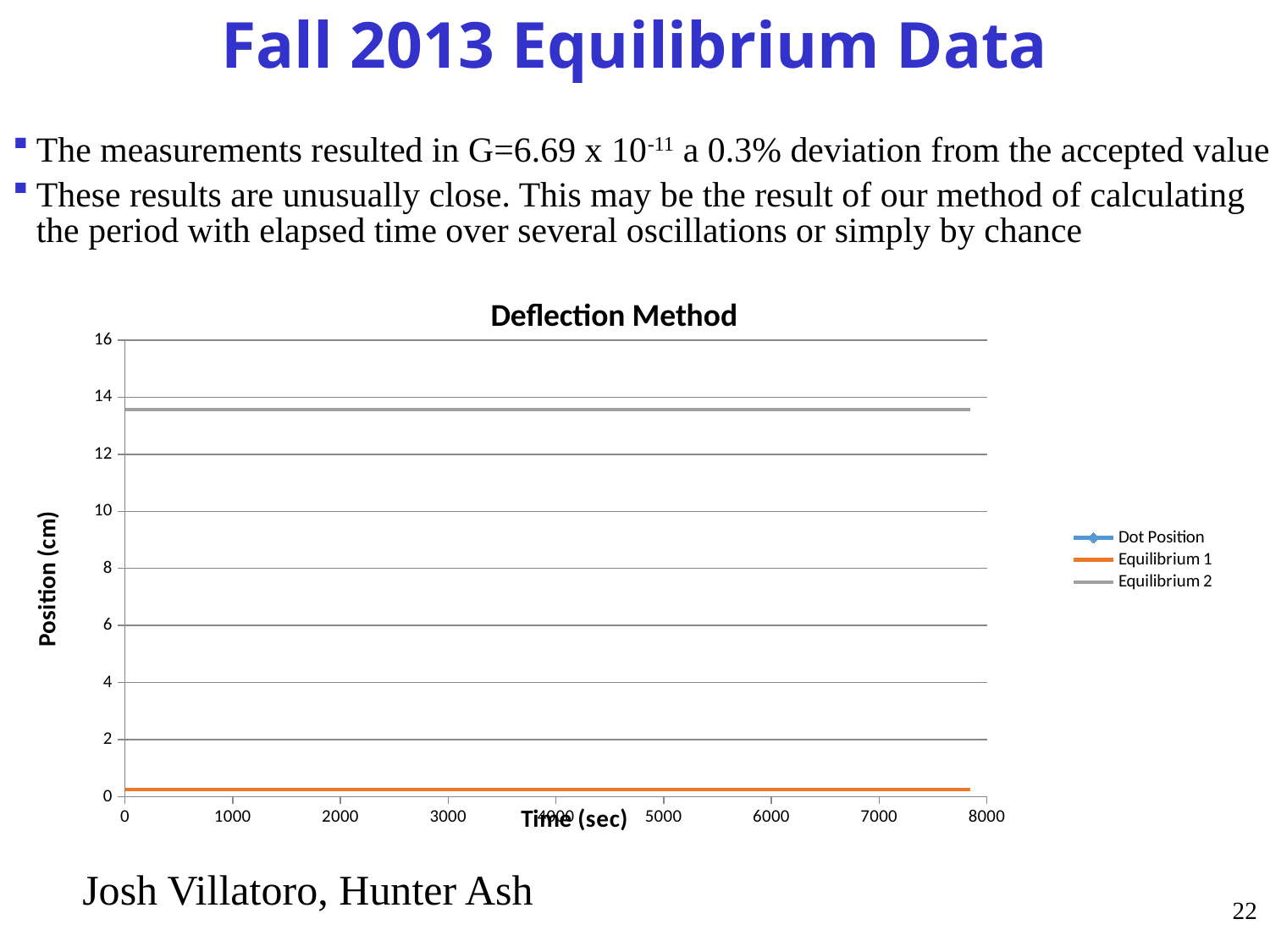
What is the title of the chart on the slide? Deflection Method What is the label of the vertical axis of the chart? Position (cm) What is the highest value shown on the vertical axis of the chart? 16 Which series has the higher position, Equilibrium 1 or Equilibrium 2? Equilibrium 2 Is the value of the Equilibrium 2 line greater or less than 12? greater Does the Equilibrium 2 line rise, fall, or stay flat as time increases? stays flat Is the value of the Equilibrium 2 line greater or less than 14? less What kind of chart is shown on the slide? line chart Is the value of the Equilibrium 1 line greater or less than 2? less How many series does the legend of the Deflection Method chart list? 3